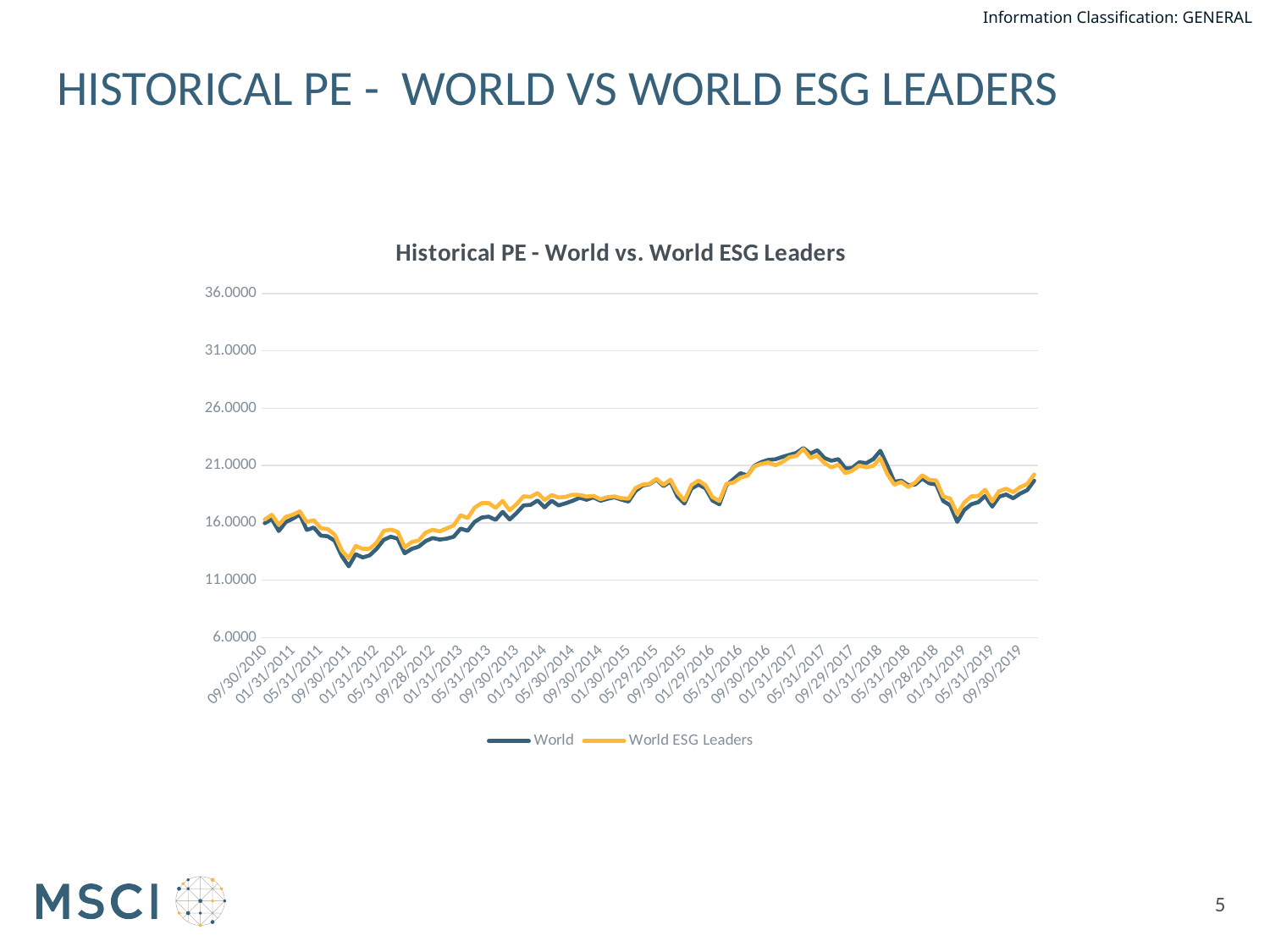
What is the title of the chart? Historical PE - World vs. World ESG Leaders What is the first date label on the x axis? 09/30/2010 How many series does the chart legend list? 2 Is the World ESG Leaders value at 01/31/2012 greater or less than 16.0000? less Is the World ESG Leaders value at 09/30/2019 greater or less than 16.0000? greater What kind of chart is shown on the slide? Line chart Is the World value at 09/30/2011 greater or less than 16.0000? less Do the values generally rise or fall between 09/30/2011 and 01/31/2017? rise What is the highest value shown on the y axis? 36.0000 Which series is drawn in yellow/orange? World ESG Leaders At 09/30/2011, which series has the higher value, World or World ESG Leaders? World ESG Leaders